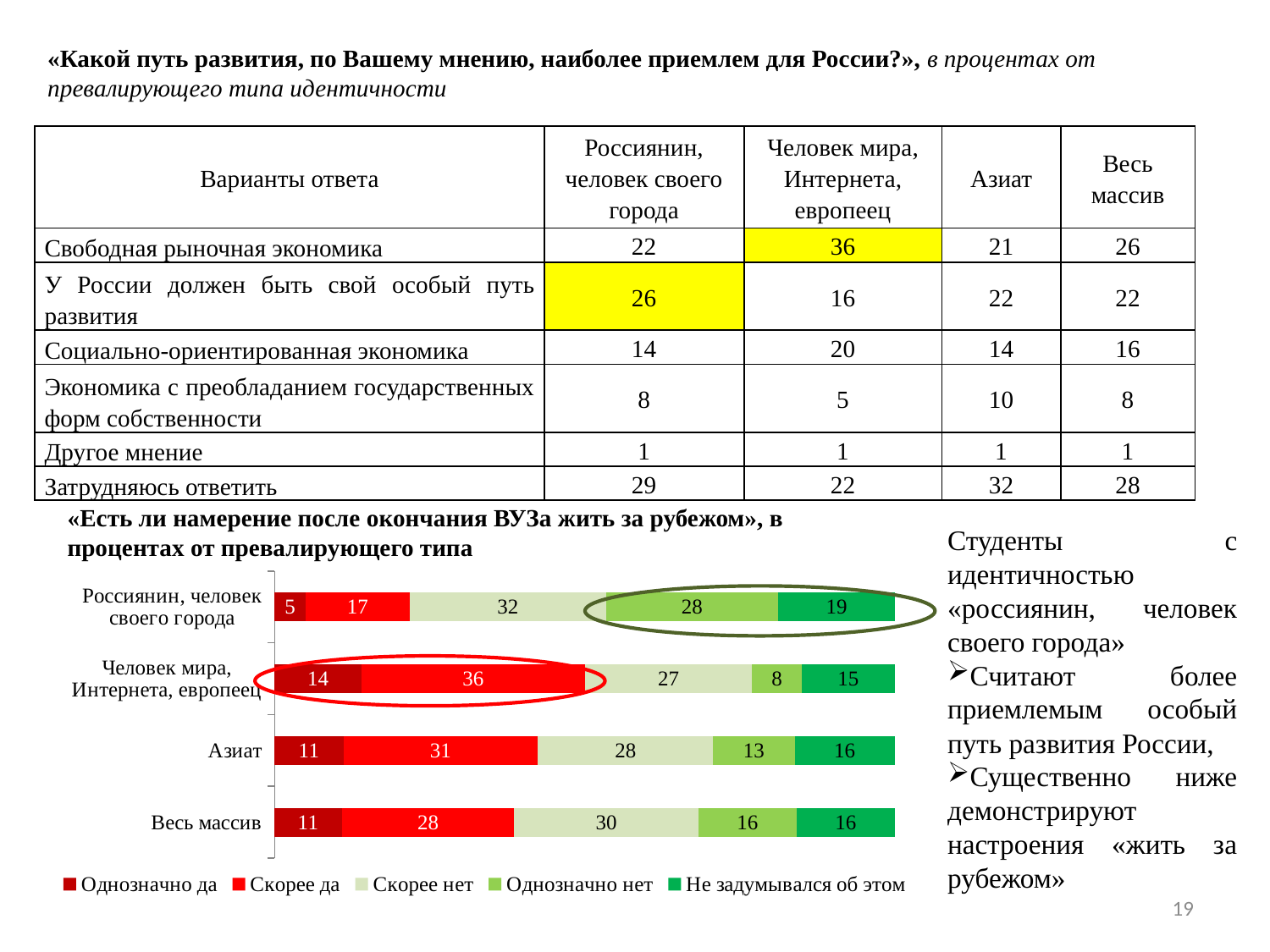
In the bar chart, what is the value of «Скорее да» for «Человек мира, Интернета, европеец»? 36 In the bar chart, what is the value of «Скорее нет» for «Весь массив»? 30 In the bar chart, which category has the highest value for «Скорее да»? Человек мира, Интернета, европеец How many categories (identity types) are shown on the bar chart? 4 In the bar chart, what is the value of «Не задумывался об этом» for «Азиат»? 16 In the bar chart, which is larger: «Однозначно нет» for «Россиянин, человек своего города» or for «Азиат»? Россиянин, человек своего города In the bar chart, what is the value of «Однозначно нет» for «Россиянин, человек своего города»? 28 What type of chart is shown on the slide? Stacked bar chart What is the total of the stacked bar for «Человек мира, Интернета, европеец»? 100 In the bar chart, which category has the lowest value for «Однозначно да»? Россиянин, человек своего города In the bar chart, what is the difference between the «Скорее да» values for «Человек мира, Интернета, европеец» and «Россиянин, человек своего города»? 19 How many series does the legend of the bar chart list? 5